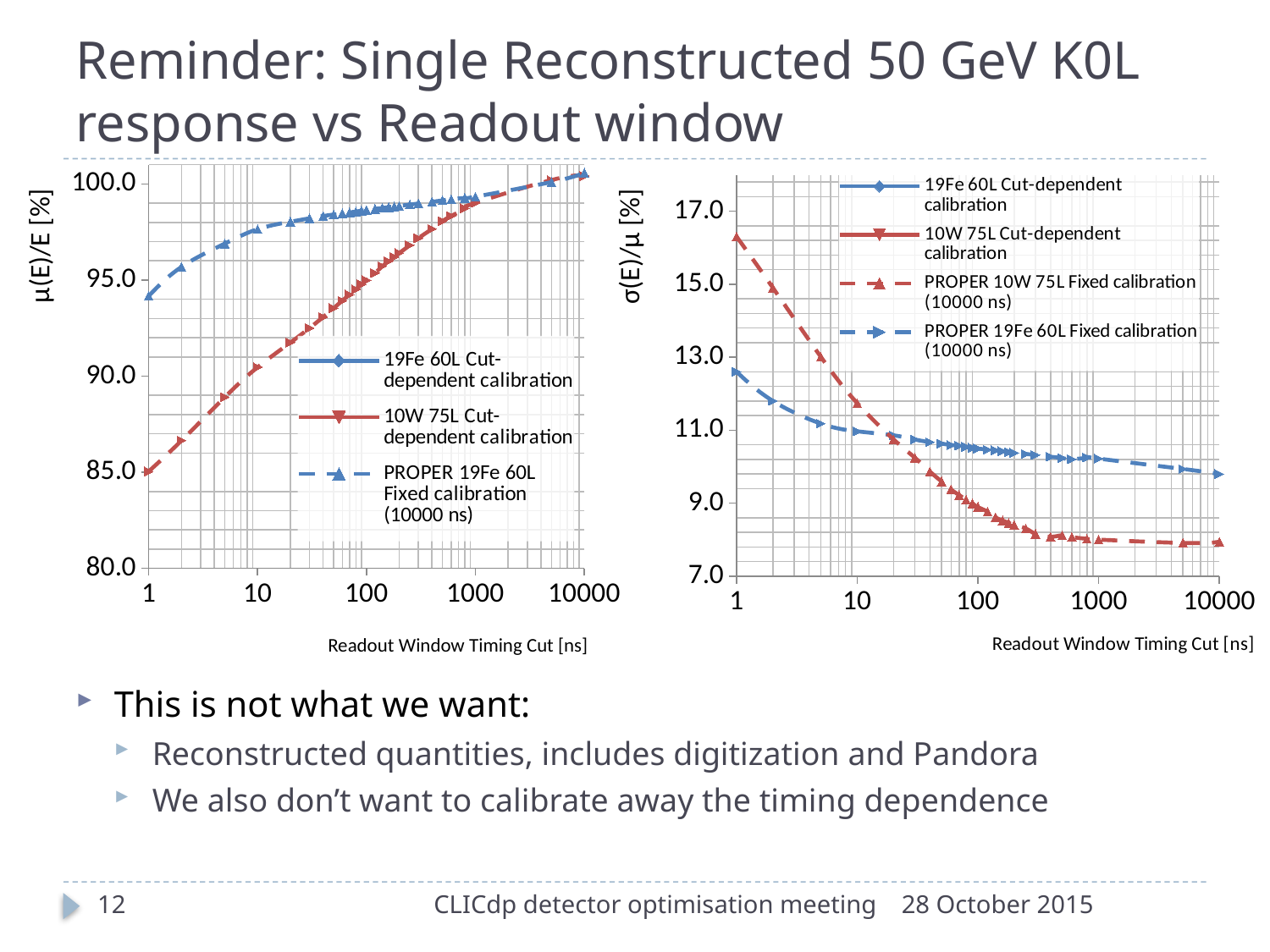
How many series does the legend of the left chart (μ(E)/E [%]) list? 3 In the right chart (σ(E)/μ [%]), at 10000 ns, which series has the higher value: the PROPER 19Fe 60L Fixed calibration or the PROPER 10W 75L Fixed calibration? PROPER 19Fe 60L Fixed calibration In the right chart (σ(E)/μ [%]), is the value of the PROPER 10W 75L Fixed calibration series at 10000 ns greater or less than 9.0? less In the right chart (σ(E)/μ [%]), do the values of the PROPER 10W 75L Fixed calibration series rise or fall as the Readout Window Timing Cut increases? fall What is the x-axis label of the right chart (σ(E)/μ [%])? Readout Window Timing Cut [ns] In the right chart (σ(E)/μ [%]), is the value of the PROPER 10W 75L Fixed calibration series at 1 ns greater or less than 15.0? greater What kind of chart is the left chart (μ(E)/E [%] vs Readout Window Timing Cut)? line chart How many series does the legend of the right chart (σ(E)/μ [%]) list? 4